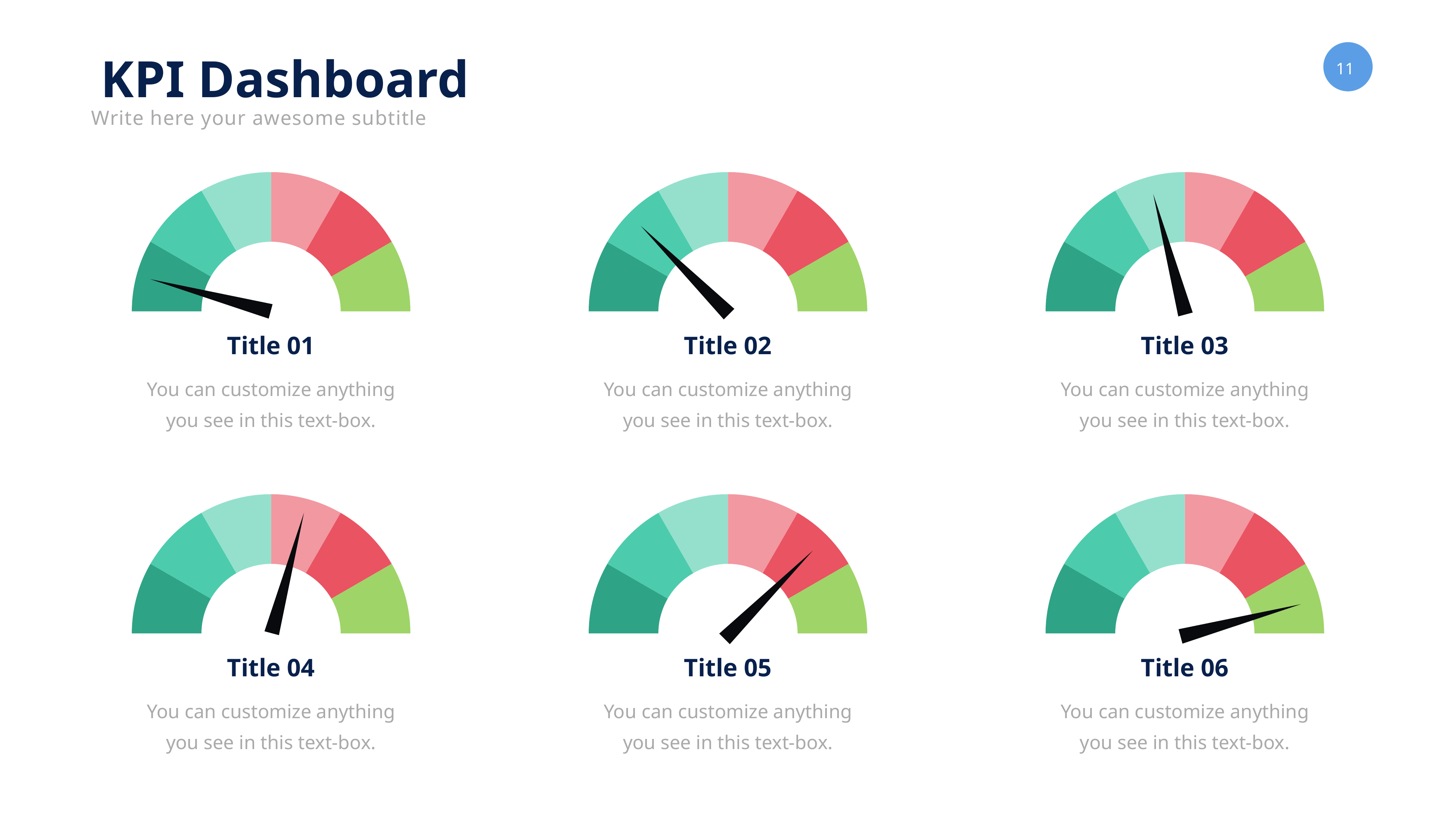
What is the title of the gauge in the top-left position of the slide? Title 01 Which gauge's needle points furthest to the right (highest position)? Title 06 Which gauge's needle points furthest to the left (lowest position)? Title 01 How many coloured segments does each gauge on the slide have? 6 Is the needle of the Title 04 gauge positioned higher or lower than the needle of the Title 03 gauge? Higher What kind of chart is used for each of the six KPIs on the slide? Gauge chart What colour is the segment at the far right end of each gauge? Light green How many gauge charts are shown on the slide? 6 Is the needle of the Title 05 gauge positioned higher or lower than the needle of the Title 02 gauge? Higher